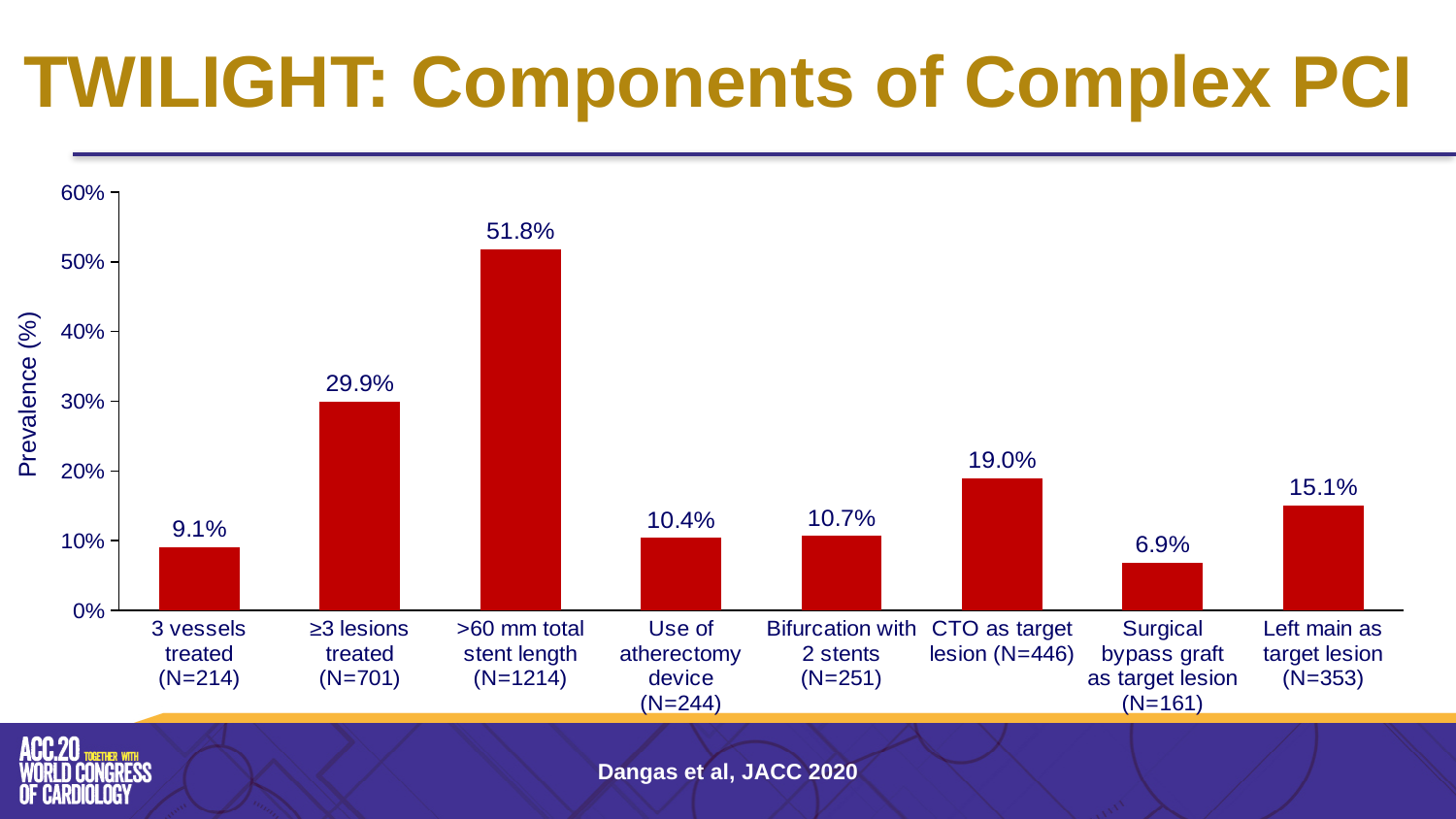
How many components of complex PCI are shown on the chart? 8 What is the title of the slide? TWILIGHT: Components of Complex PCI What is the difference in prevalence between '≥3 lesions treated (N=701)' and '3 vessels treated (N=214)'? 20.8% What is the prevalence for 'CTO as target lesion (N=446)'? 19.0% Which component of complex PCI has the highest prevalence? >60 mm total stent length (N=1214) What is the prevalence for '>60 mm total stent length (N=1214)'? 51.8% Is the prevalence for '≥3 lesions treated (N=701)' greater or less than 20%? greater What is the prevalence for 'Surgical bypass graft as target lesion (N=161)'? 6.9% Which has a higher prevalence: 'Left main as target lesion (N=353)' or 'Bifurcation with 2 stents (N=251)'? Left main as target lesion (N=353) What kind of chart is shown on the slide? bar chart What is the label of the y axis? Prevalence (%) Which component of complex PCI has the lowest prevalence? Surgical bypass graft as target lesion (N=161)